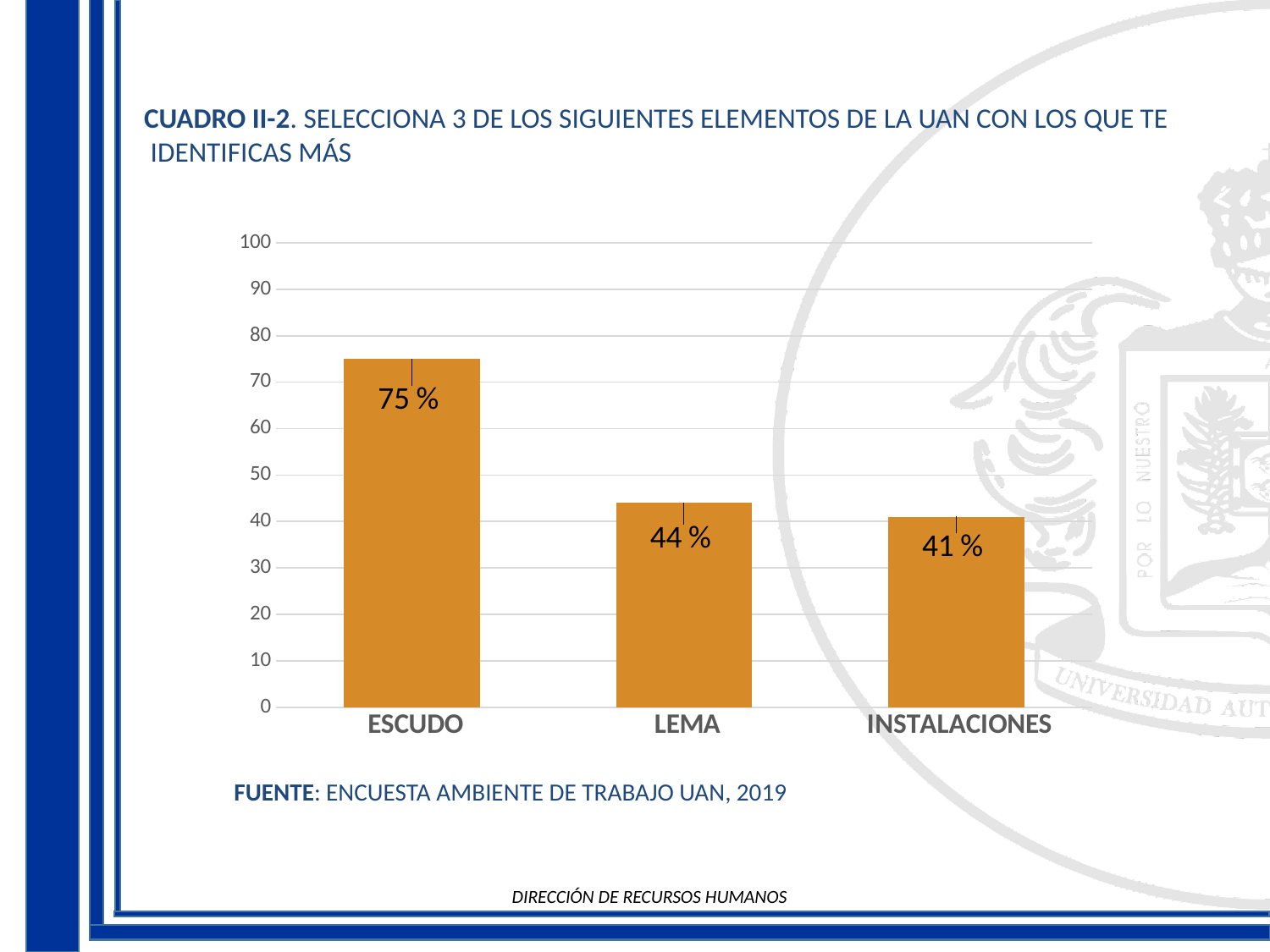
Which category has the highest value? ESCUDO What is the value for ESCUDO? 75 % Which is larger, the value for ESCUDO or the value for INSTALACIONES? ESCUDO What is the difference between the values for ESCUDO and LEMA? 31 % How many categories are shown on the chart? 3 What is the value for INSTALACIONES? 41 % Is the value for ESCUDO greater or less than 70? greater What is the value for LEMA? 44 % What source is cited below the chart? ENCUESTA AMBIENTE DE TRABAJO UAN, 2019 Which category has the lowest value? INSTALACIONES What kind of chart is shown on the slide? bar chart What is the difference between the values for LEMA and INSTALACIONES? 3 %